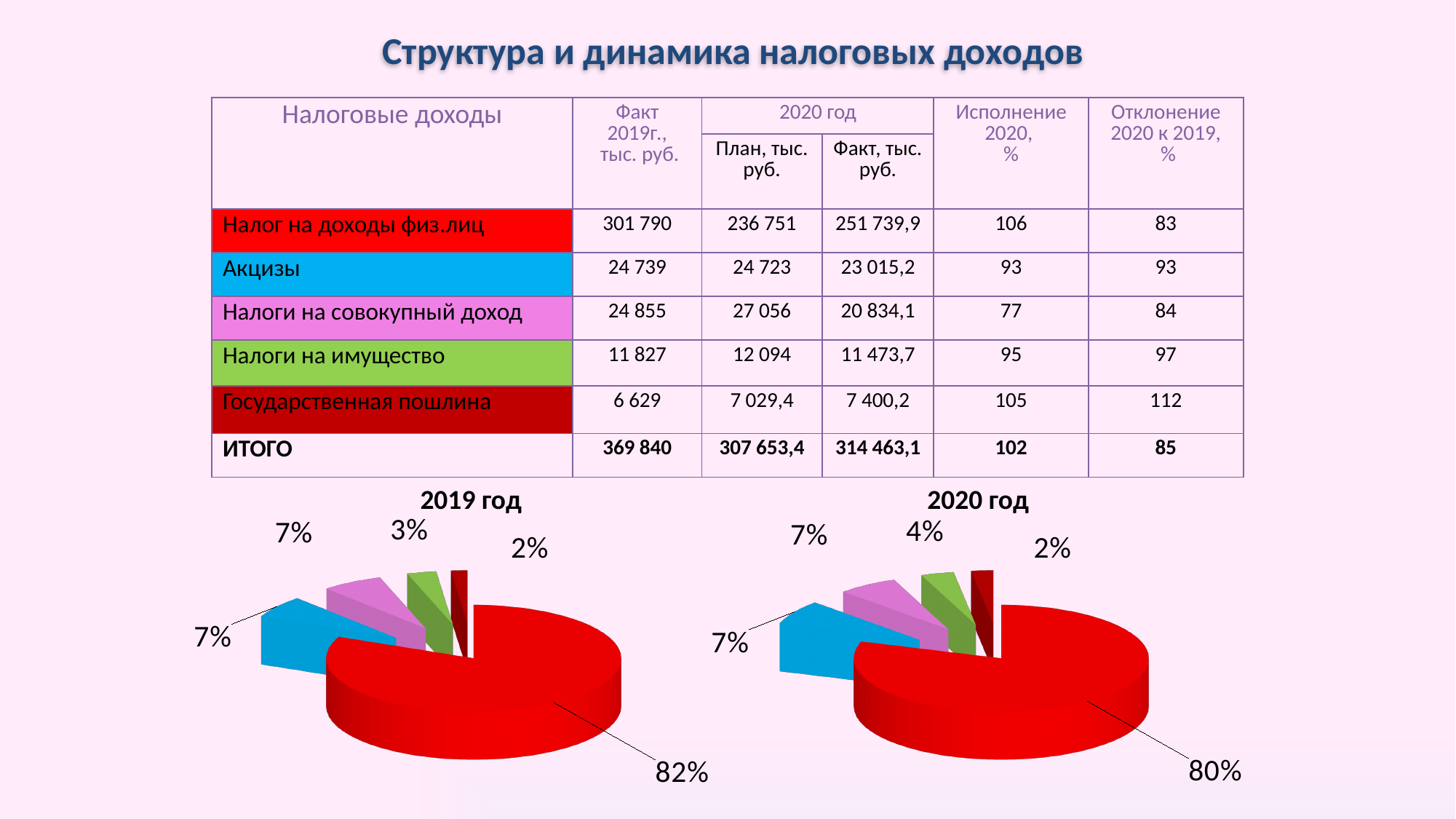
Which slice is the smallest in the "2019 год" pie chart? the dark red slice (Государственная пошлина), 2% In the "2019 год" pie chart, what share does the green slice (Налоги на имущество) have? 3% In the "2020 год" pie chart, what share does the green slice (Налоги на имущество) have? 4% In the "2019 год" pie chart, what share does the largest (red) slice have? 82% Which is larger in the "2020 год" pie chart: the green slice or the dark red slice? the green slice (4%) What are the titles of the two pie charts on the slide? 2019 год and 2020 год How many slices does the "2020 год" pie chart have? 5 What kind of chart is the "2019 год" chart? pie chart By how many percentage points does the largest slice of the "2019 год" pie chart exceed the largest slice of the "2020 год" pie chart? 2 percentage points